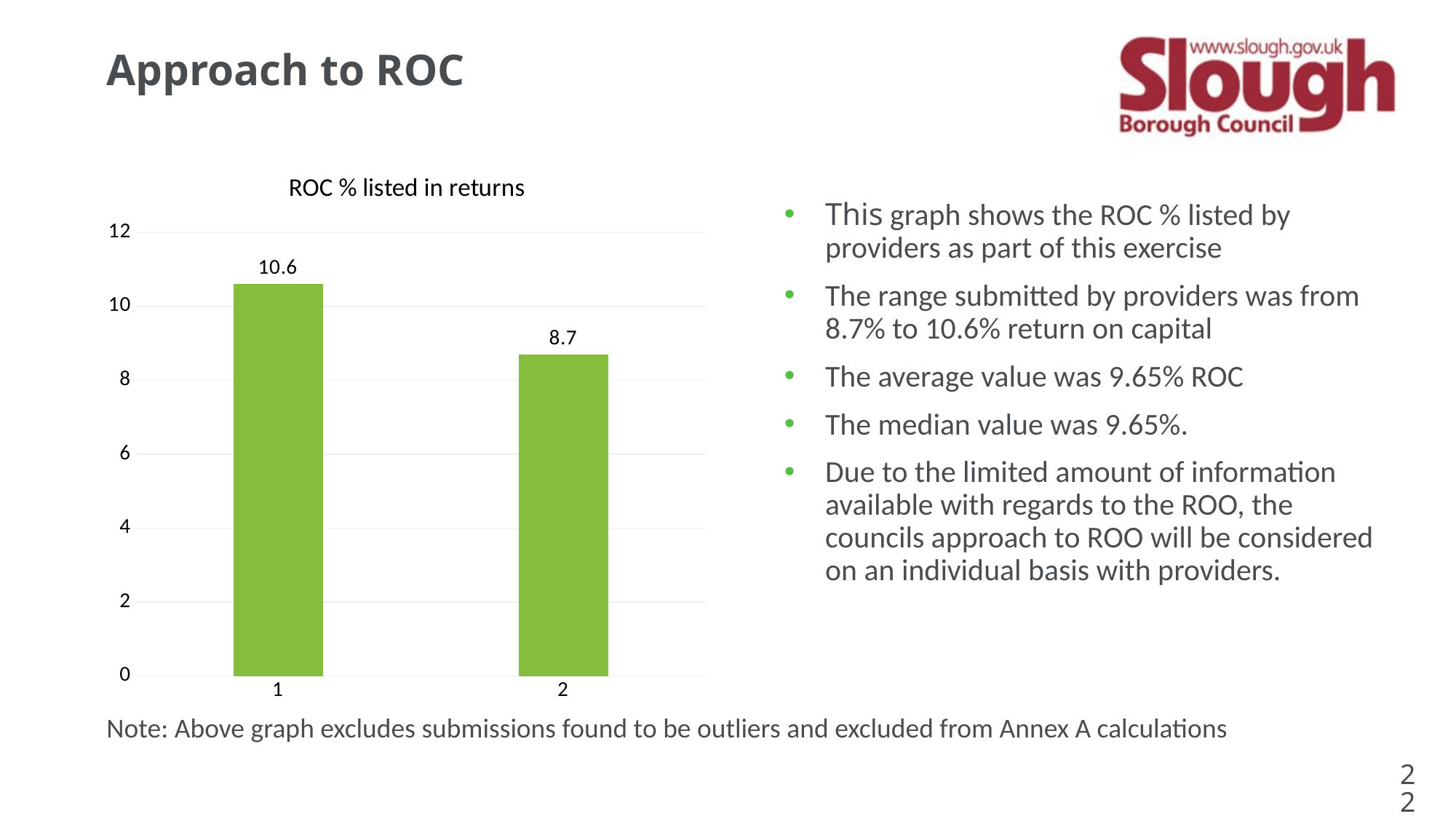
Which category has the lowest value? 2 Which category has the highest value? 1 What is the title of the chart? ROC % listed in returns Which is larger, the value for category 1 or category 2? 1 What is the difference between the values for category 1 and category 2? 1.9 How many bars are shown in the chart? 2 Is the value for category 2 greater or less than 10? less Is the value for category 1 greater or less than 10? greater What is the value for category 1? 10.6 What is the value for category 2? 8.7 Do the values rise or fall from category 1 to category 2? fall What kind of chart is shown on the slide? bar chart